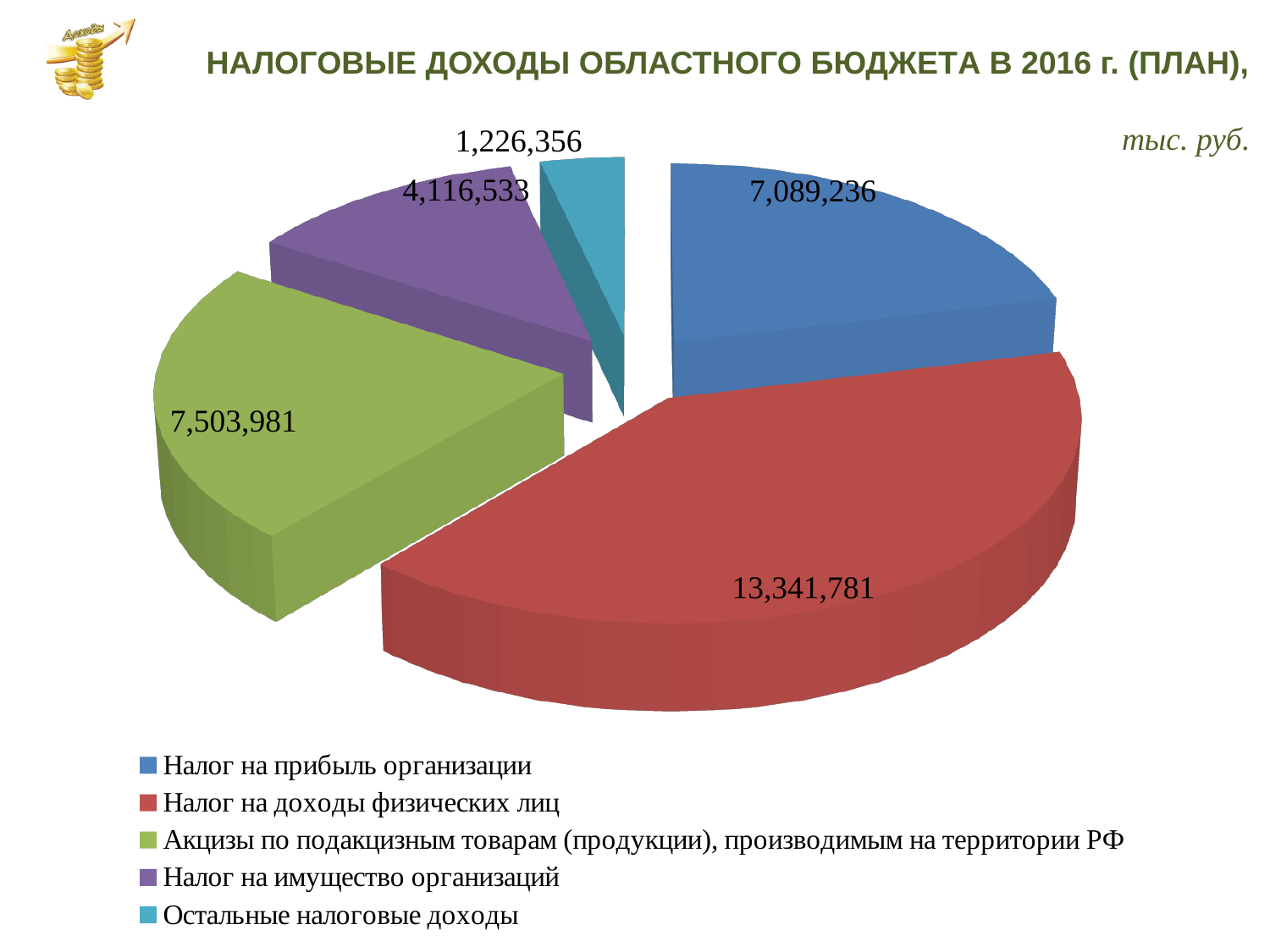
What type of chart is shown on the slide? Pie chart Which category has the smallest value? Остальные налоговые доходы What is the value for Остальные налоговые доходы? 1,226,356 What is the value for Налог на прибыль организации? 7,089,236 How many categories does the pie chart have? 5 What is the value for Налог на имущество организаций? 4,116,533 What unit of measurement is indicated on the slide for the chart values? тыс. руб. What is the value for Налог на доходы физических лиц? 13,341,781 What is the difference between Налог на доходы физических лиц and Акцизы по подакцизным товарам? 5,837,800 What is the value for Акцизы по подакцизным товарам (продукции), производимым на территории РФ? 7,503,981 Which category has the largest value? Налог на доходы физических лиц Which is larger: Акцизы по подакцизным товарам or Налог на прибыль организации? Акцизы по подакцизным товарам